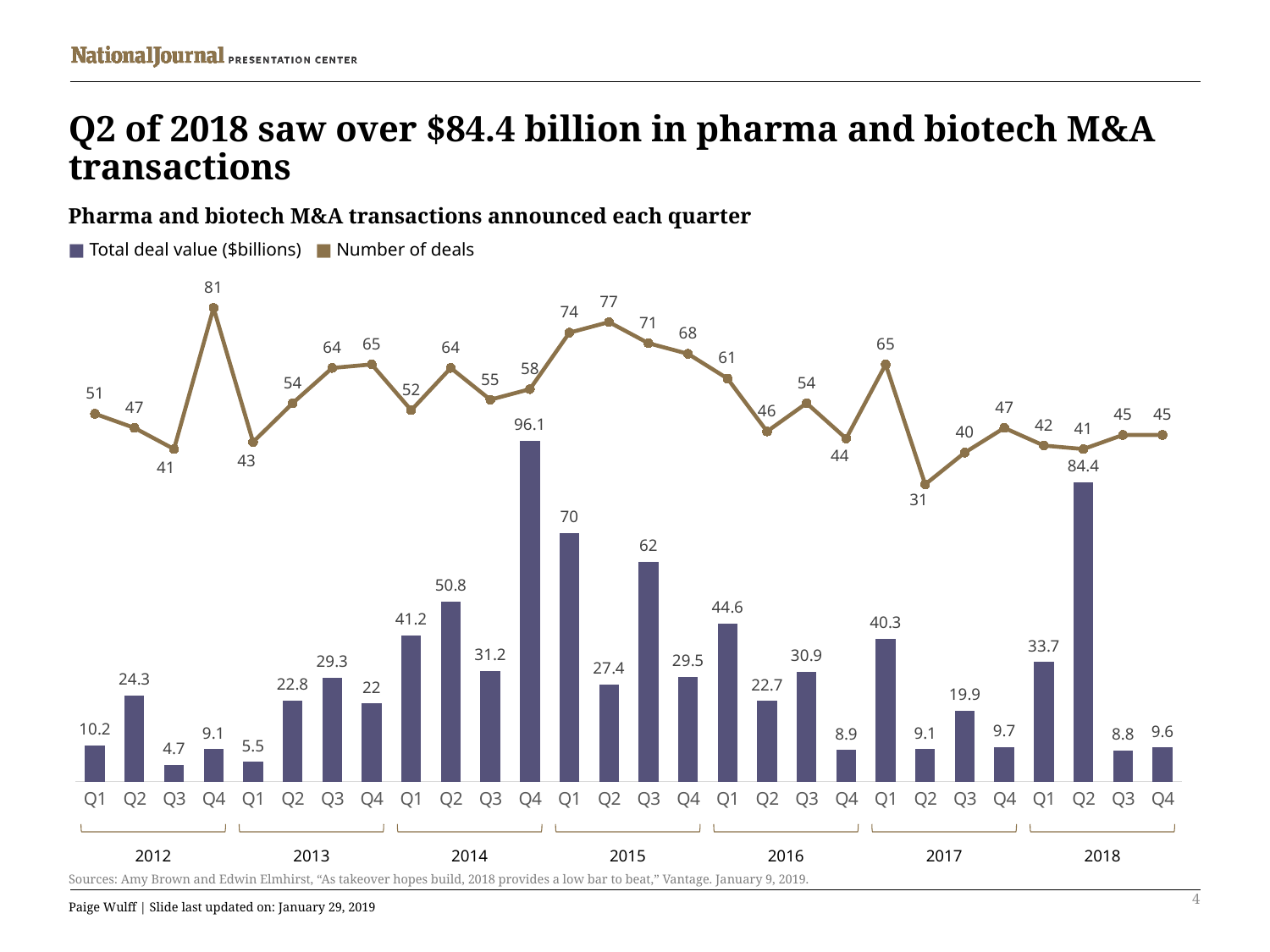
How many quarters are shown on the x axis? 28 How many series does the legend list? 2 Which had more deals, Q2 2015 or Q1 2017? Q2 2015 How many deals were announced in Q4 of 2012? 81 What is the difference in total deal value between Q4 2014 and Q2 2018? 11.7 Which quarter had the lowest total deal value? Q3 2012 Which series is shown as a line? Number of deals What kind of chart is this? Combined bar and line chart Which quarter had the lowest number of deals? Q2 2017 What was the total deal value in Q2 of 2018? 84.4 What was the total deal value in Q4 of 2014? 96.1 Which quarter had the highest total deal value? Q4 2014